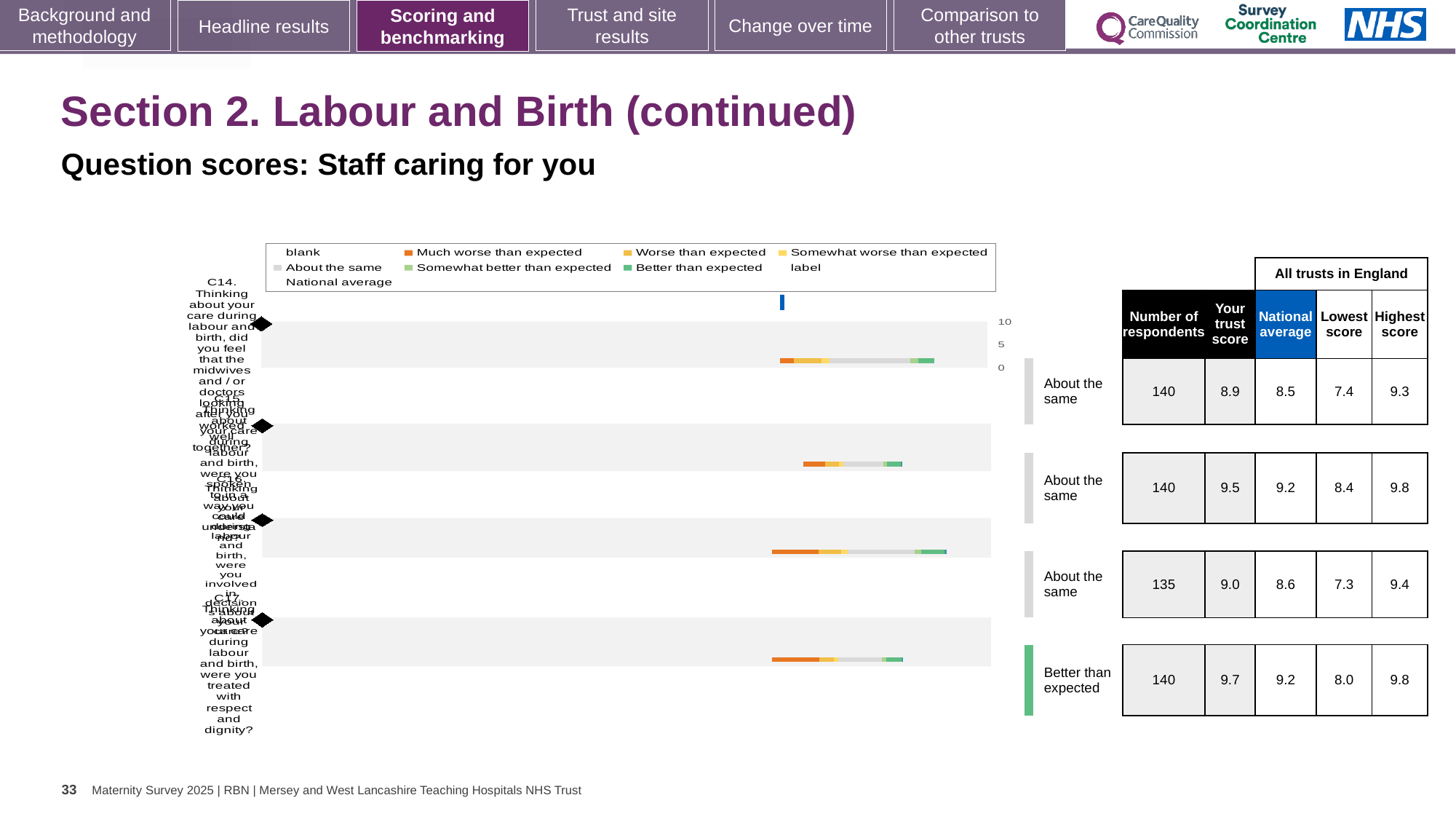
In the table beside the chart, which row has the highest 'Your trust score'? C17 (treated with respect and dignity) How many question rows (C14 to C17) are plotted in the chart? 4 What colour is the legend entry for 'Much worse than expected'? orange How many entries does the chart legend list? 9 In the table beside the chart, what is the 'Your trust score' for the first row (C14)? 8.9 In the table beside the chart, what is the national average for the last row (C17)? 9.2 In the table beside the chart, which row is rated 'Better than expected'? C17 (treated with respect and dignity) What kind of chart is shown on the slide? bar chart What is the highest value shown on the chart's axis? 10 In the table beside the chart, which row has the lowest 'Your trust score'? C14 (midwives and/or doctors worked well together) In the table beside the chart, what is the 'Your trust score' for the last row (C17, treated with respect and dignity)? 9.7 In the table beside the chart, what is the difference between the trust score and the national average for the last row (C17)? 0.5